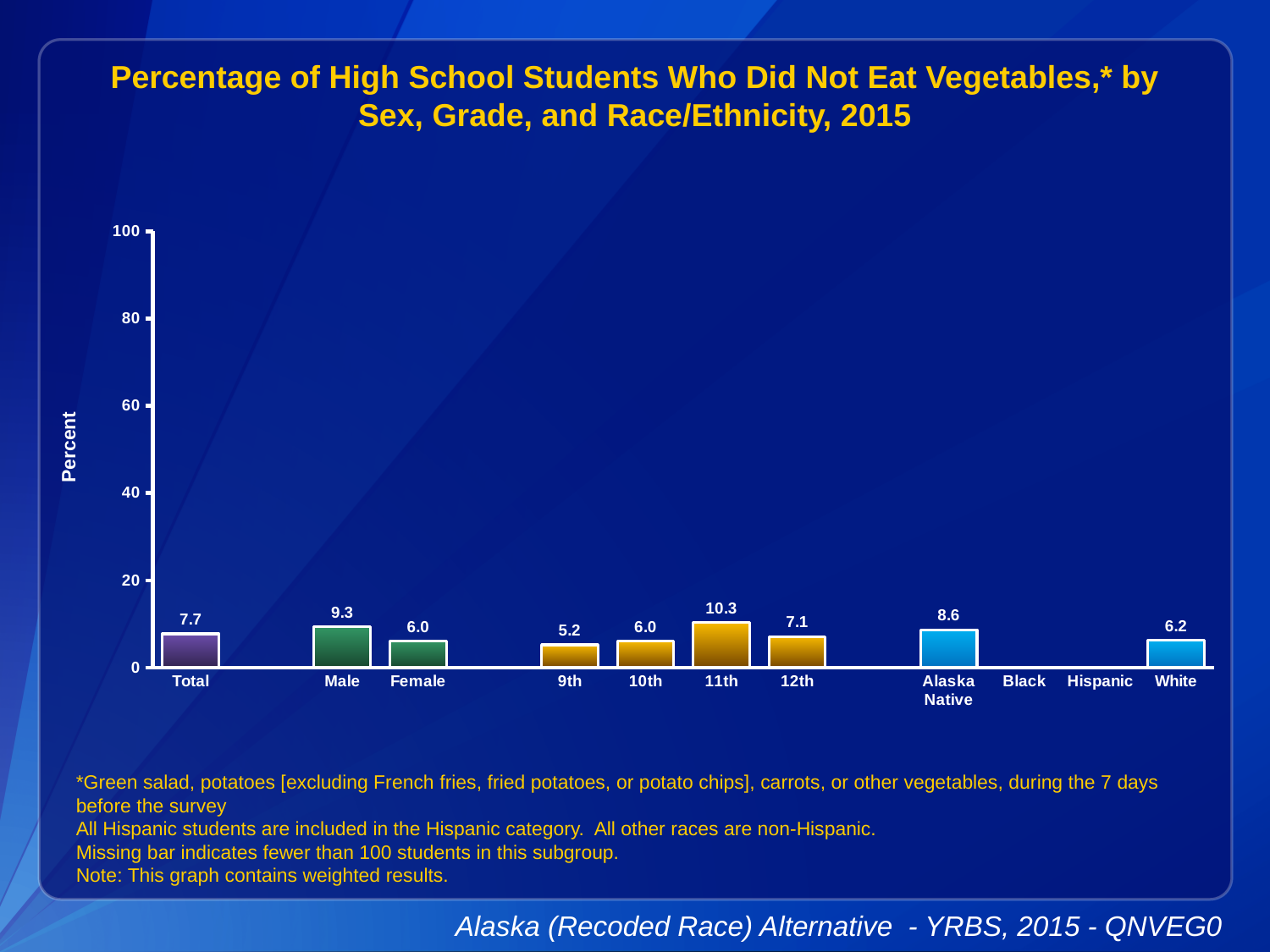
What kind of chart is shown? bar chart How many categories have a bar plotted? 9 Is the value for 11th grade greater or less than 20? less Which is larger, the value for Alaska Native or the value for White? Alaska Native Which category has the highest value? 11th What is the difference between the Male and Female values? 3.3 What is the value for Alaska Native? 8.6 Which grade has the lowest value? 9th Which categories have no bar shown? Black and Hispanic What is the value for Total? 7.7 What is the value for Male? 9.3 What is the value for 11th grade? 10.3